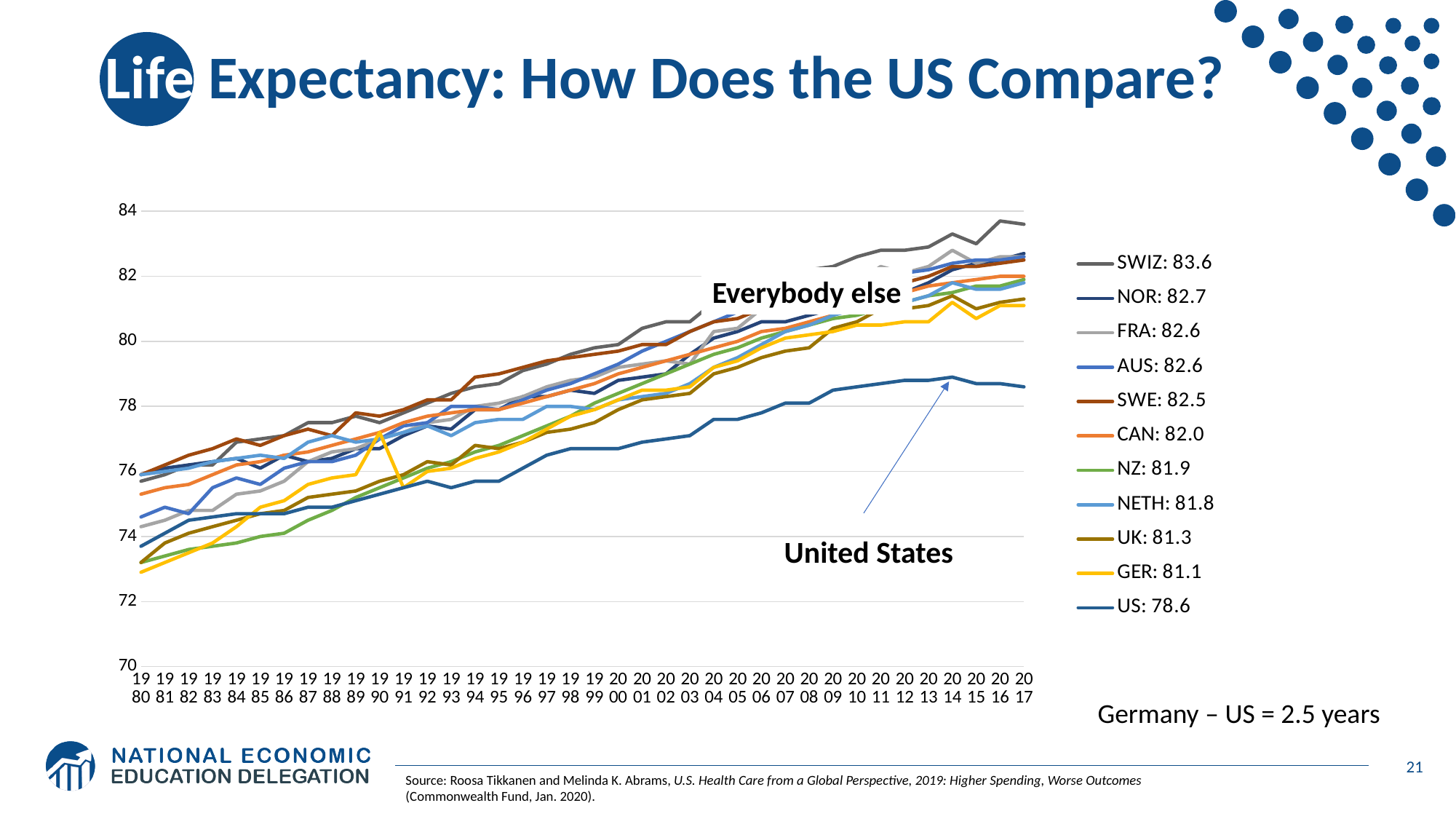
What value is shown in the legend for SWIZ? 83.6 What value is shown in the legend for GER? 81.1 According to the text on the slide, what is the gap between Germany and the US? 2.5 years How many series does the legend list? 11 Does the US line generally rise or fall from 1980 to 2017? rise What value is shown in the legend for US? 78.6 What is the difference between the legend values for SWIZ and US? 5.0 Which country has the highest value in the legend? SWIZ Which has a higher legend value, CAN or UK? CAN What kind of chart is shown on the slide? line chart Which country has the lowest value in the legend? US Is the value for US in 1980 greater or less than 74? less